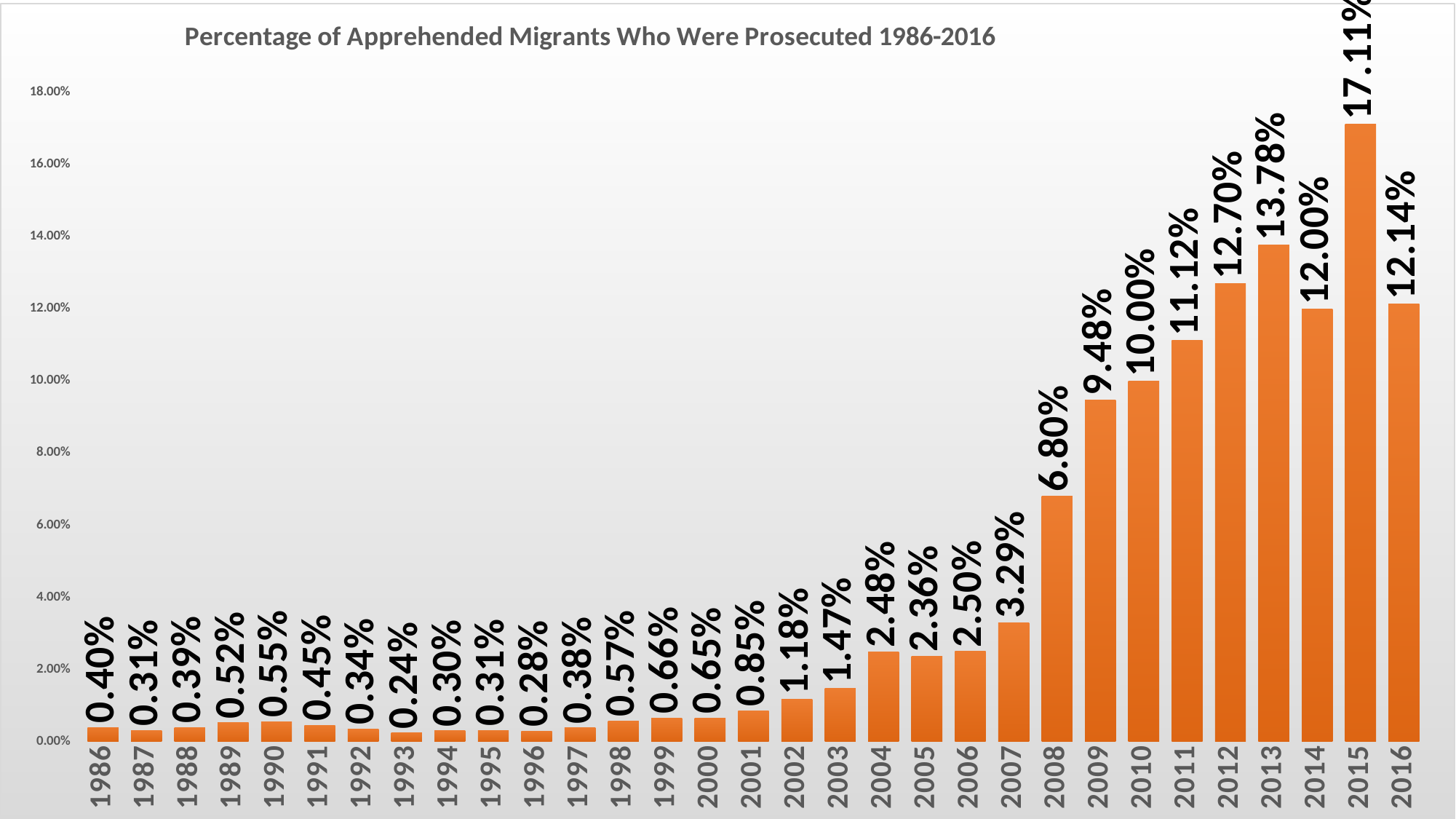
What is the value shown for 2001? 0.85% What is the difference between the values for 2015 and 2016? 4.97% What is the title of the chart? Percentage of Apprehended Migrants Who Were Prosecuted 1986-2016 Which year has the highest percentage of apprehended migrants prosecuted? 2015 What percentage of apprehended migrants were prosecuted in 2008? 6.80% How many years are shown on the x axis of the chart? 31 Which year has the lowest percentage of apprehended migrants prosecuted? 1993 Overall, do the values rise or fall from 1986 to 2016? Rise What type of chart is shown on the slide? Bar chart Which year has the larger value, 2014 or 2016? 2016 What is the value shown for 2013? 13.78% What is the difference between the values for 2013 and 2012? 1.08%